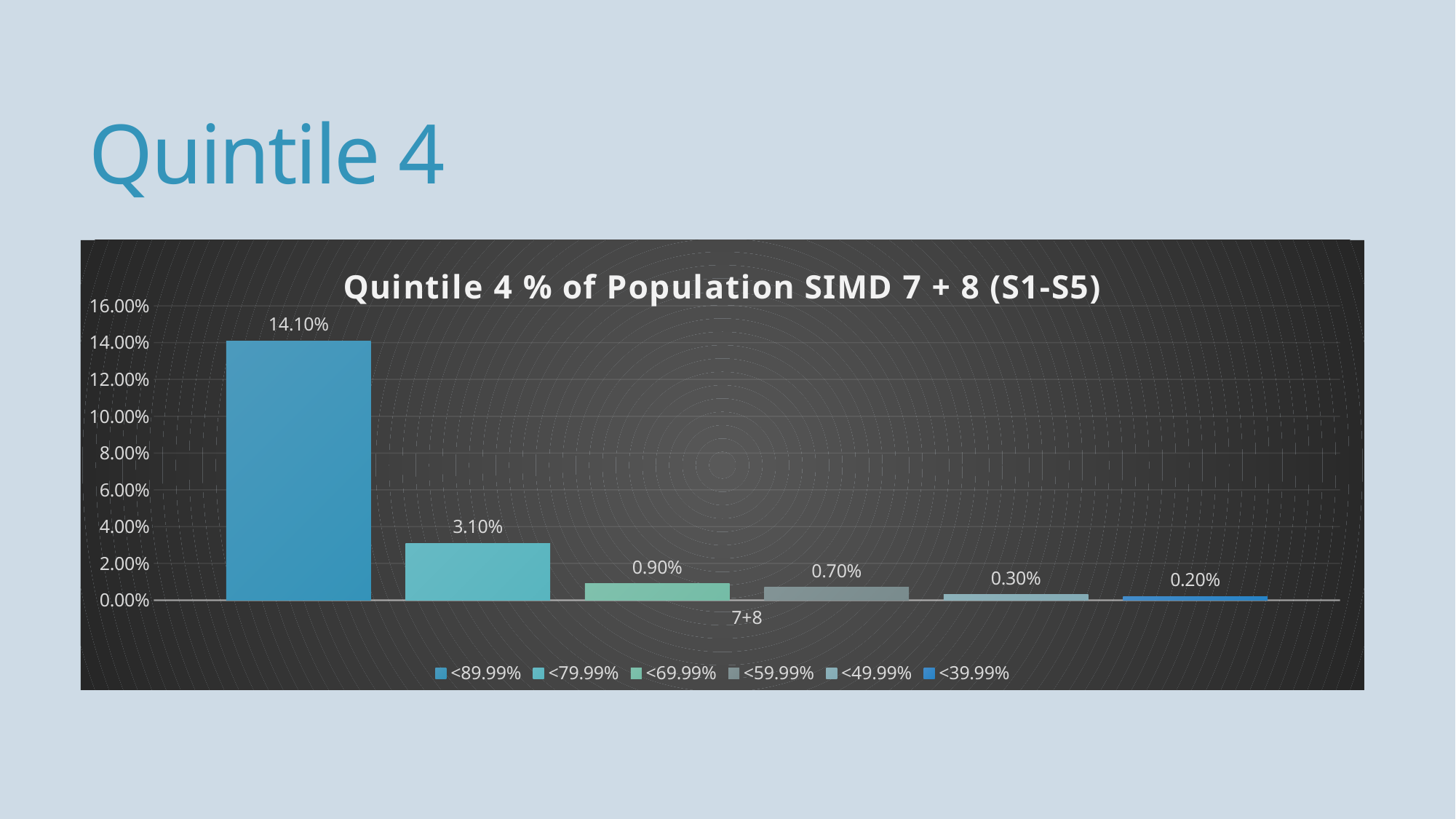
What is the value for the <69.99% series? 0.90% Which series has the highest value? <89.99% What kind of chart is shown? Bar chart What is the value for the <89.99% series? 14.10% What is the difference between the <89.99% and <79.99% values? 11.00% How many series does the legend list? 6 What is the title of the chart? Quintile 4 % of Population SIMD 7 + 8 (S1-S5) Which is larger, the value for <59.99% or the value for <49.99%? <59.99% Which series has the lowest value? <39.99% What is the value for the <79.99% series? 3.10% Is the value for <89.99% greater or less than 12.00%? greater What is the value for the <39.99% series? 0.20%